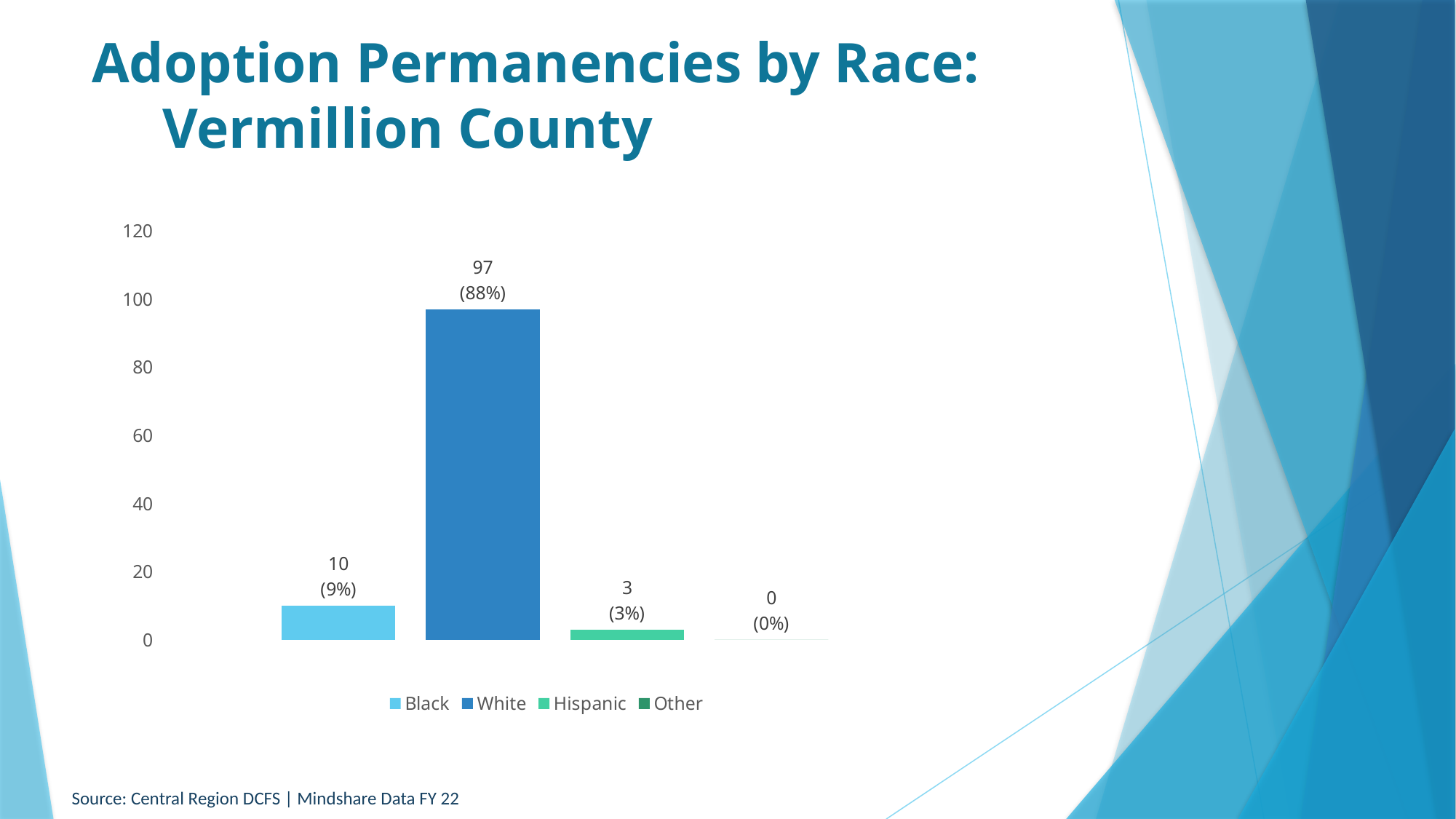
Which is larger, the value for Black or the value for Hispanic? Black What is the number of adoption permanencies for Hispanic? 3 What kind of chart is shown on the slide? Bar chart What is the source cited at the bottom of the slide? Central Region DCFS | Mindshare Data FY 22 How many race categories are shown in the chart? 4 What percentage share is shown for the Other category? 0% Which race category has the highest number of adoption permanencies? White What is the number of adoption permanencies for White? 97 What is the difference between the White and Black values? 87 Which race category has the lowest number of adoption permanencies? Other Is the value for White greater or less than 80? greater What is the number of adoption permanencies for Black? 10